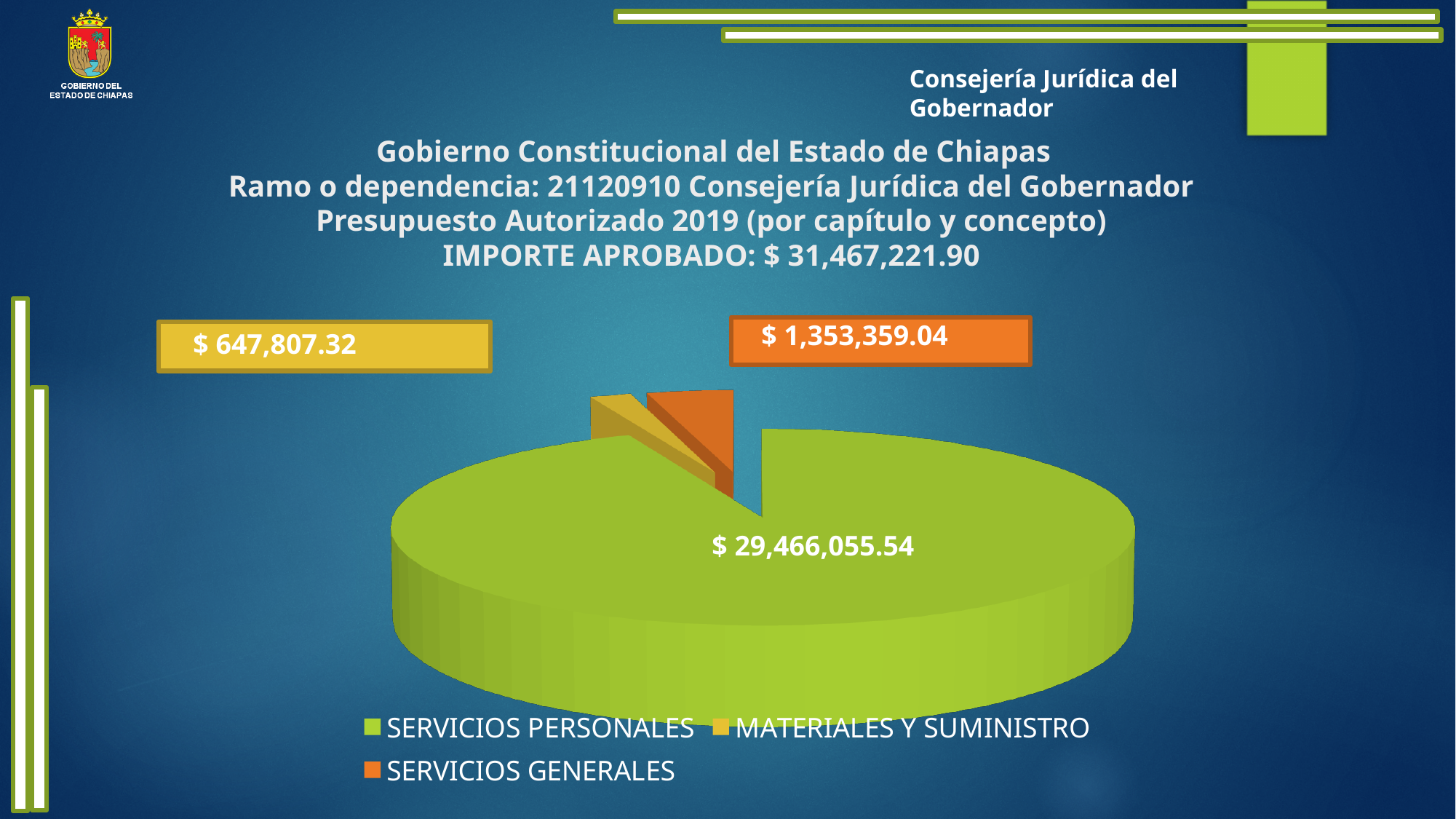
Which category has the smallest slice of the pie? MATERIALES Y SUMINISTRO What is the value for SERVICIOS PERSONALES? $ 29,466,055.54 How many categories does the pie chart have? 3 Which is larger, SERVICIOS GENERALES or MATERIALES Y SUMINISTRO? SERVICIOS GENERALES What colour is the SERVICIOS GENERALES slice? Orange What is the difference between SERVICIOS PERSONALES and SERVICIOS GENERALES? $ 28,112,696.50 What kind of chart is shown on the slide? Pie chart What is the value for SERVICIOS GENERALES? $ 1,353,359.04 What is the value for MATERIALES Y SUMINISTRO? $ 647,807.32 What is the difference between SERVICIOS GENERALES and MATERIALES Y SUMINISTRO? $ 705,551.72 What is the total of all slices in the pie chart? $ 31,467,221.90 Which category has the largest slice of the pie? SERVICIOS PERSONALES